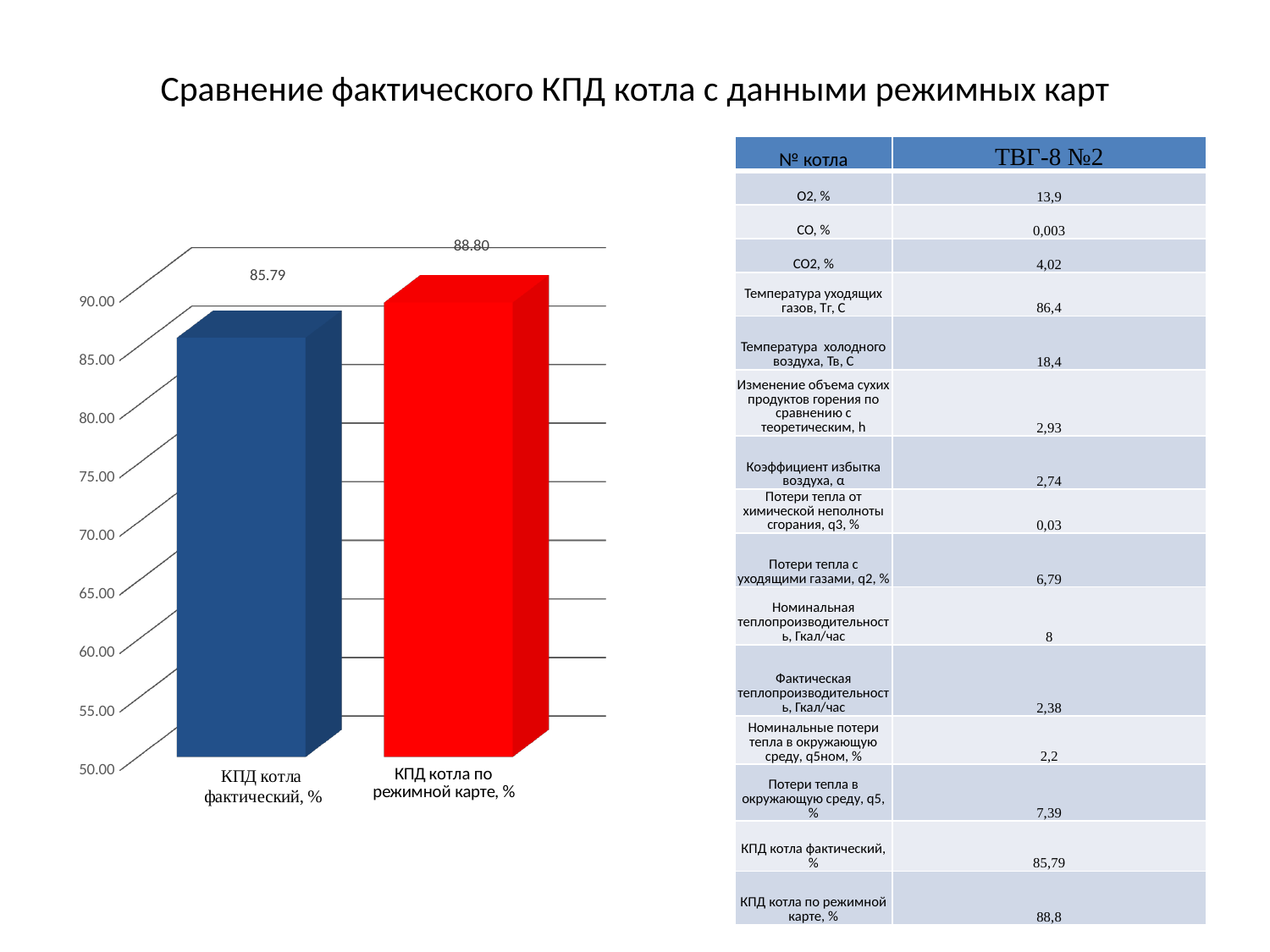
What is the value for КПД котла фактический, %? 85.79 Is the value for КПД котла фактический, % greater or less than 80.00? greater What kind of chart is shown on the slide? bar chart Which category has the lowest value? КПД котла фактический, % Which category has the highest value? КПД котла по режимной карте, % What colour is the bar for КПД котла по режимной карте, %? red How many bars are shown in the chart? 2 Which is larger: the value for КПД котла фактический, % or the value for КПД котла по режимной карте, %? КПД котла по режимной карте, % What is the title of the slide containing the chart? Сравнение фактического КПД котла с данными режимных карт What is the difference between the value for КПД котла по режимной карте, % and the value for КПД котла фактический, %? 3.01 Is the value for КПД котла по режимной карте, % greater or less than 90.00? less What is the value for КПД котла по режимной карте, %? 88.80